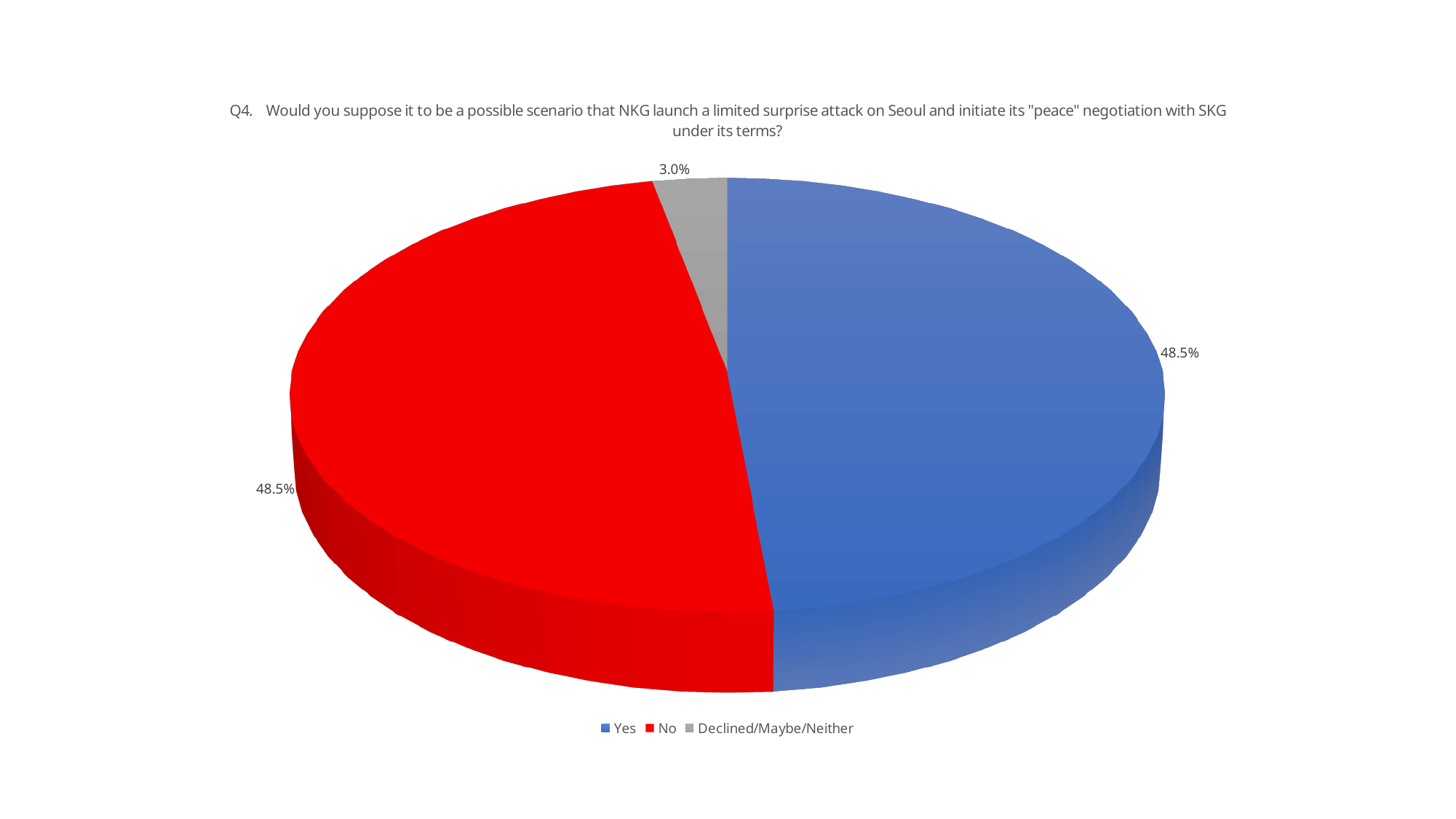
How many categories does the legend list? 3 What kind of chart is shown on the slide? Pie chart Which category has the smallest share of the pie? Declined/Maybe/Neither What is the difference between the "Yes" share and the "Declined/Maybe/Neither" share? 45.5% What colour represents the "No" category? Red What percentage of respondents answered "No"? 48.5% What is the combined share of "Yes" and "No" responses? 97.0% What percentage of respondents answered "Yes"? 48.5% What colour represents the "Yes" category? Blue What percentage of respondents are in the "Declined/Maybe/Neither" category? 3.0% Which is larger, the "No" share or the "Declined/Maybe/Neither" share? No